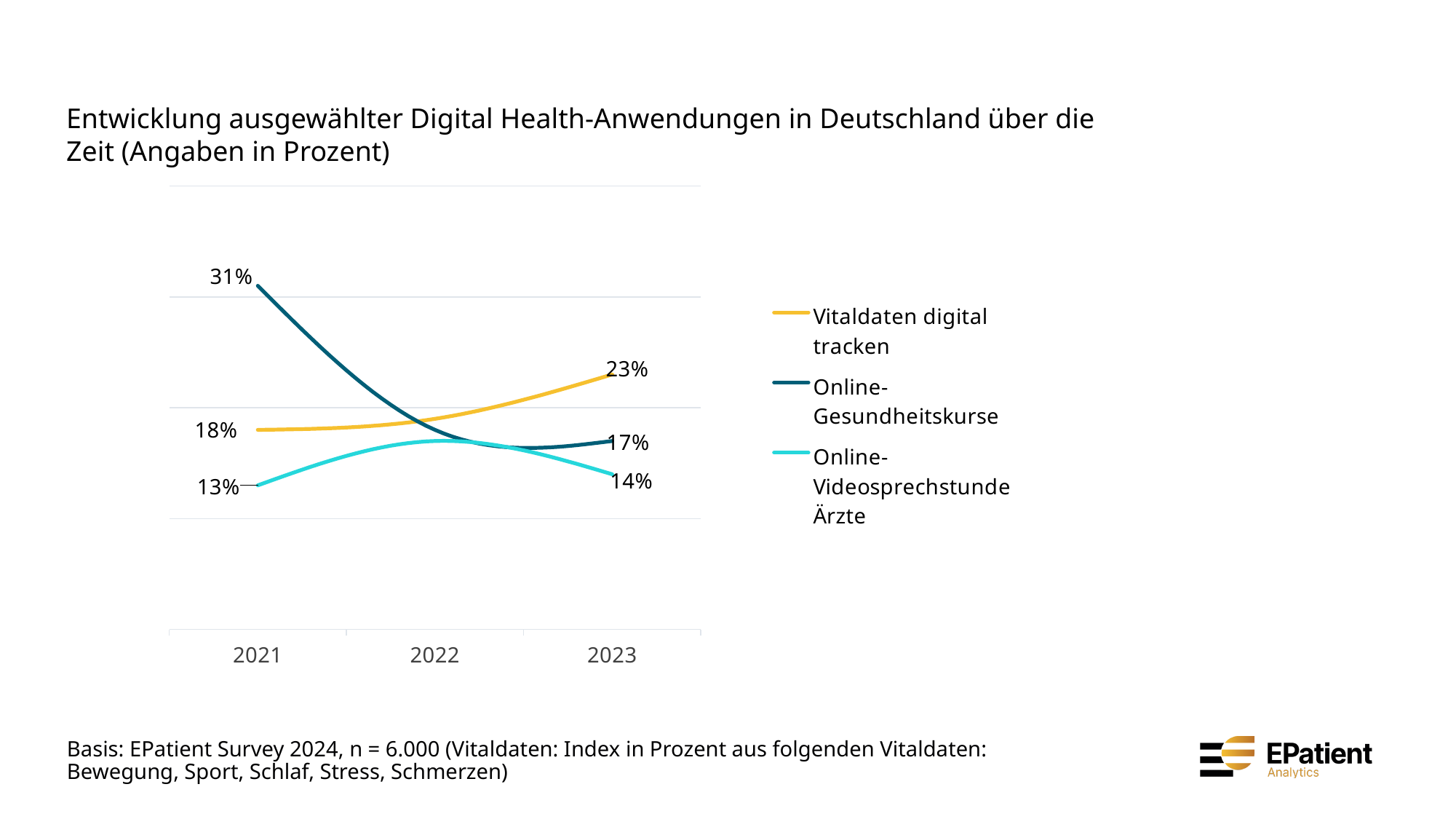
What is the value for Online-Videosprechstunde Ärzte in 2021? 13% Does the value for Vitaldaten digital tracken rise or fall from 2021 to 2023? rise What is the value for Vitaldaten digital tracken in 2023? 23% Which series has the lowest value in 2023? Online-Videosprechstunde Ärzte Which series has the highest value in 2021? Online-Gesundheitskurse What is the value for Online-Gesundheitskurse in 2021? 31% How many series does the legend list? 3 What is the value for Online-Gesundheitskurse in 2023? 17% By how many percentage points did Online-Gesundheitskurse fall from 2021 to 2023? 14 What type of chart is shown on the slide? line chart Which is larger in 2023: Vitaldaten digital tracken or Online-Gesundheitskurse? Vitaldaten digital tracken How many years are shown on the x axis? 3